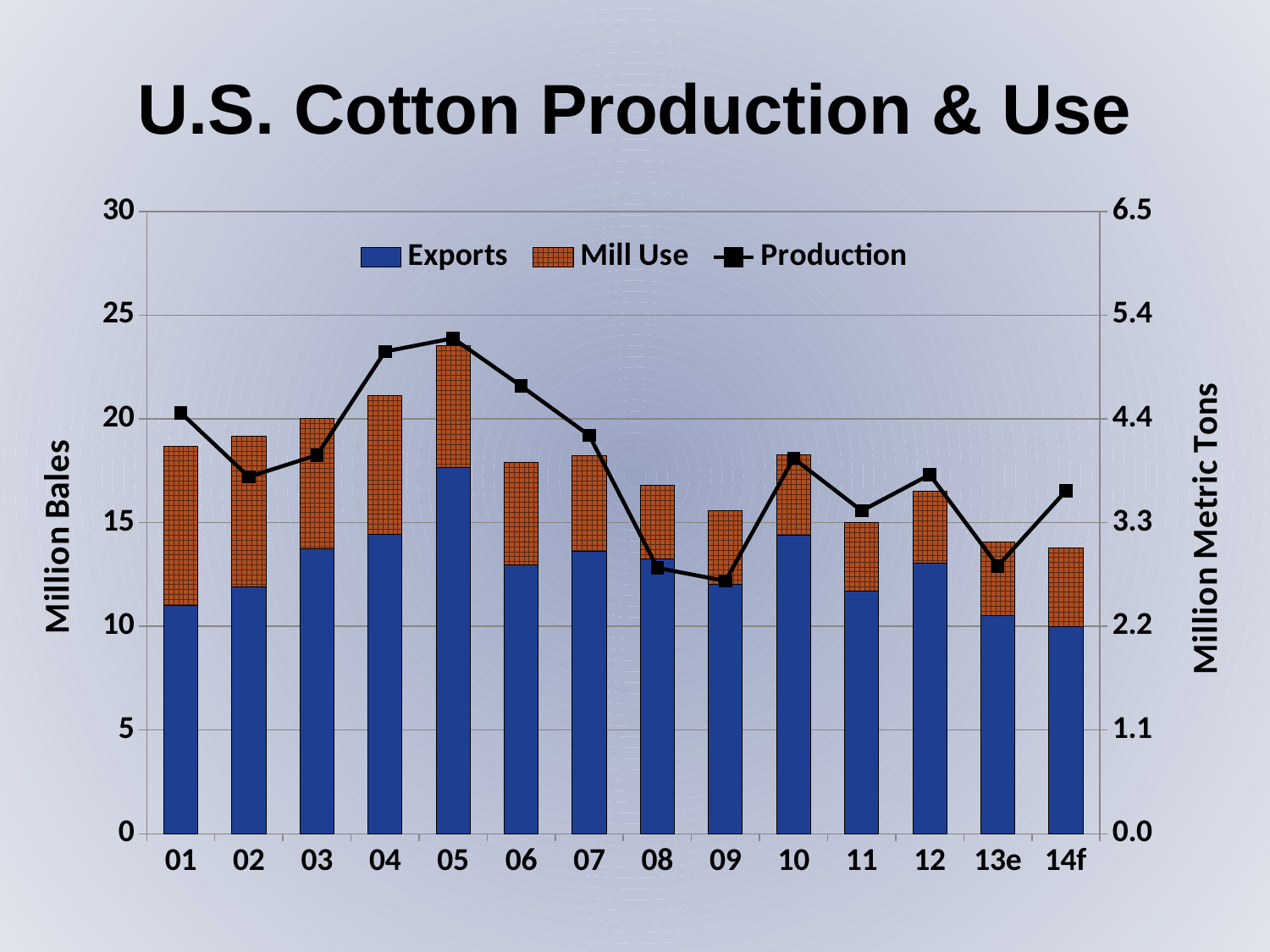
Is the Production value for 09 greater or less than 3.3 million metric tons? less Which year has the highest Production value? 05 Is the Exports value for 01 greater or less than 15 million bales? less Is the total of the stacked bar for 05 greater or less than 20 million bales? greater How many years (categories) are shown on the x axis? 14 Which year has the lowest Production value? 09 Does Production rise or fall from 05 to 09? fall Which year has the tallest stacked bar (Exports plus Mill Use)? 05 What kind of chart is shown on the slide? A combination chart with stacked bars and a line Which is larger, the Exports value for 05 or for 10? 05 What is the label of the left vertical axis? Million Bales How many series does the legend list? 3